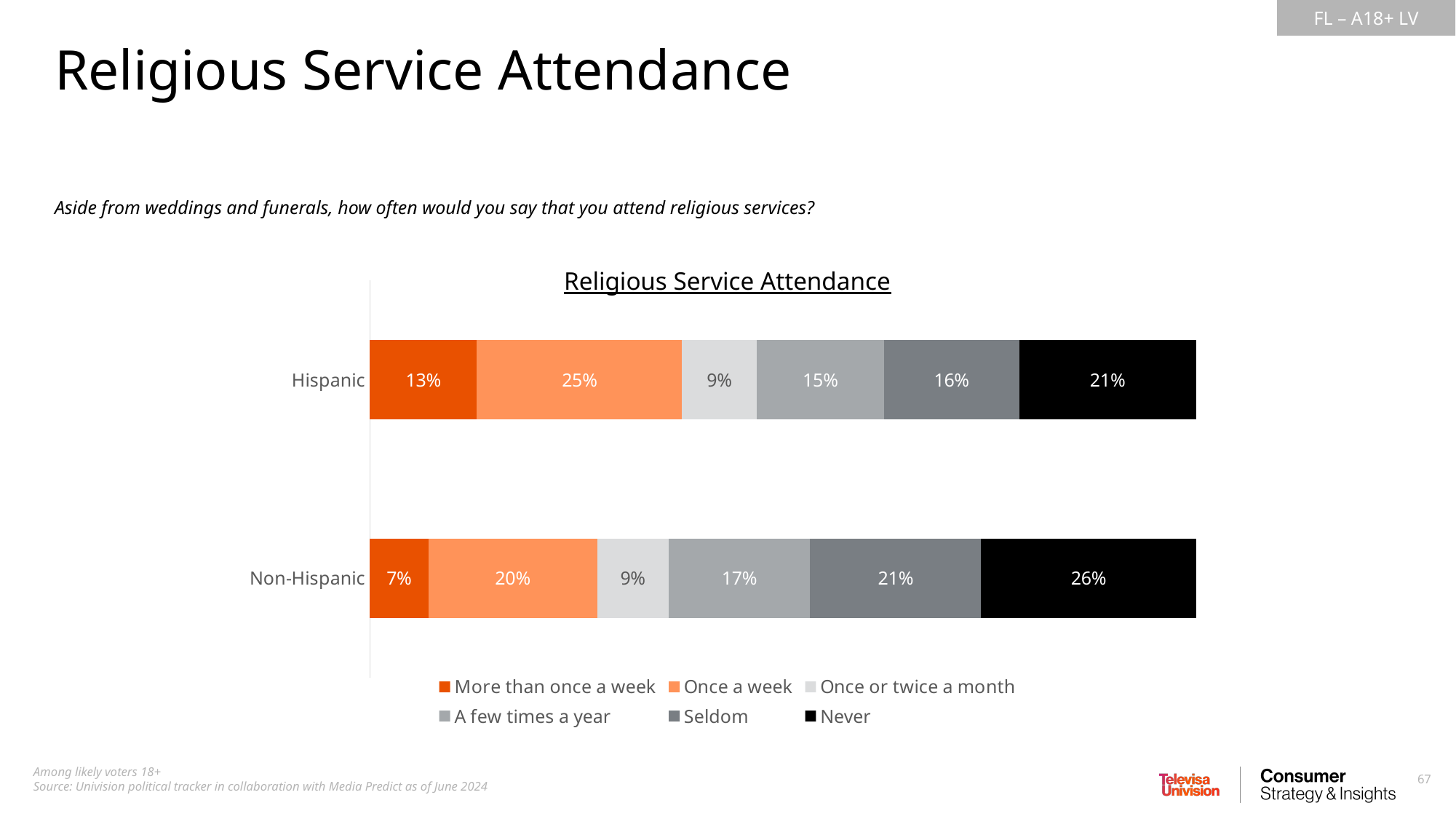
Which response category has the highest value in the Hispanic bar? Once a week What is the value for 'More than once a week' in the Non-Hispanic bar? 7% What kind of chart is shown on the slide? Stacked bar chart How many groups (bars) are shown in the chart? 2 Which response category has the lowest value in the Non-Hispanic bar? More than once a week What is the value for 'Seldom' in the Hispanic bar? 16% What is the difference between the Hispanic and Non-Hispanic values for 'More than once a week'? 6 percentage points How many series does the legend list? 6 Which group has a larger share answering 'Never', Hispanic or Non-Hispanic? Non-Hispanic What percentage of Non-Hispanic likely voters say they never attend religious services? 26% Which colour represents 'Never' in the chart? Black What percentage of Hispanic likely voters attend religious services once a week? 25%